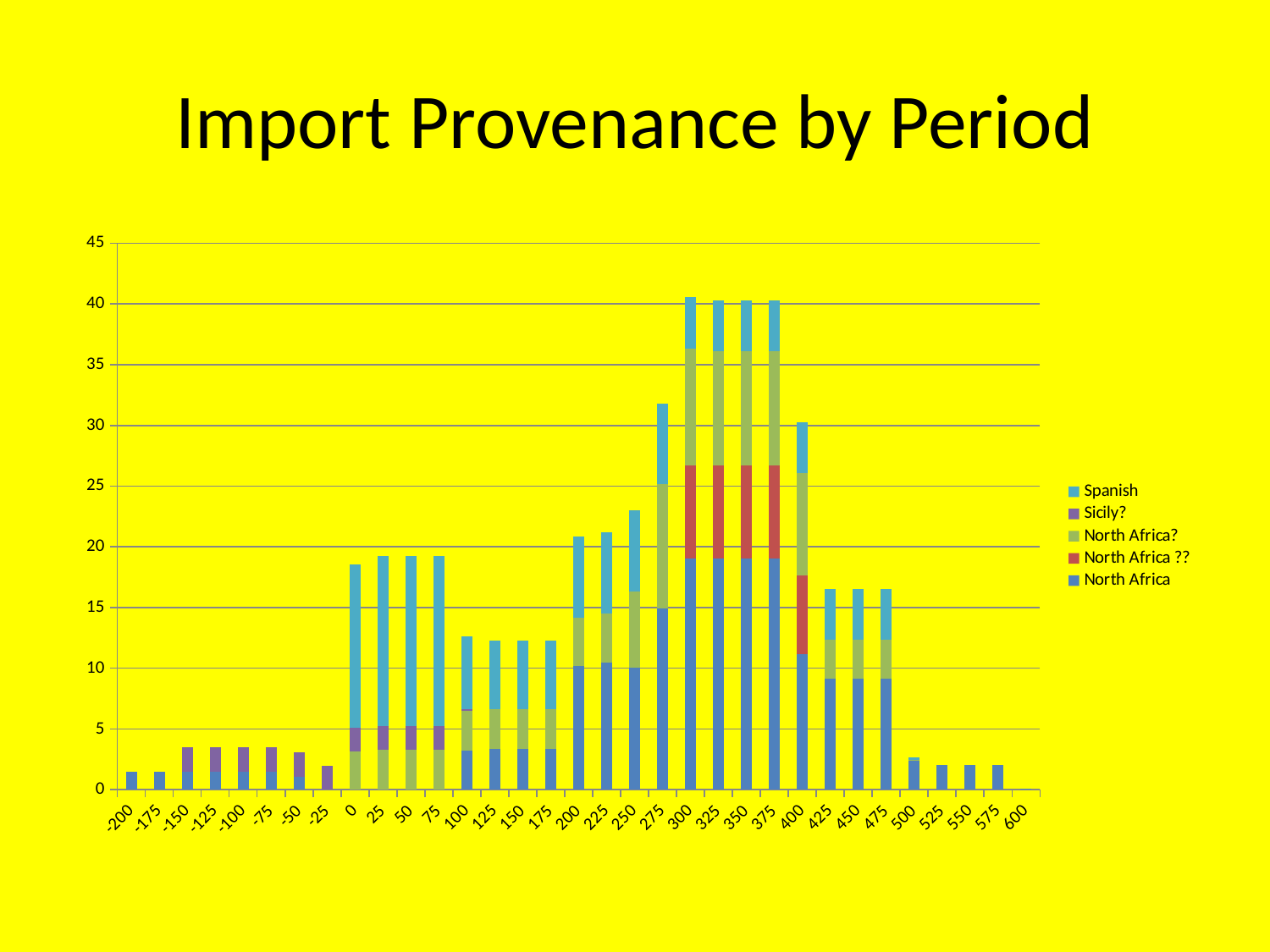
Is the total for period 400 greater or less than 25? greater How many series does the legend list? 5 Is the total for period 300 greater or less than 35? greater Do the bar totals rise or fall from period 375 to period 600? fall Is the total for period 500 greater or less than 5? less How many period categories are shown on the x axis? 33 Which series is listed first in the legend? Spanish What type of chart is shown on the slide? Stacked bar chart What is the title of the chart? Import Provenance by Period Which has the larger total, period 250 or period 275? 275